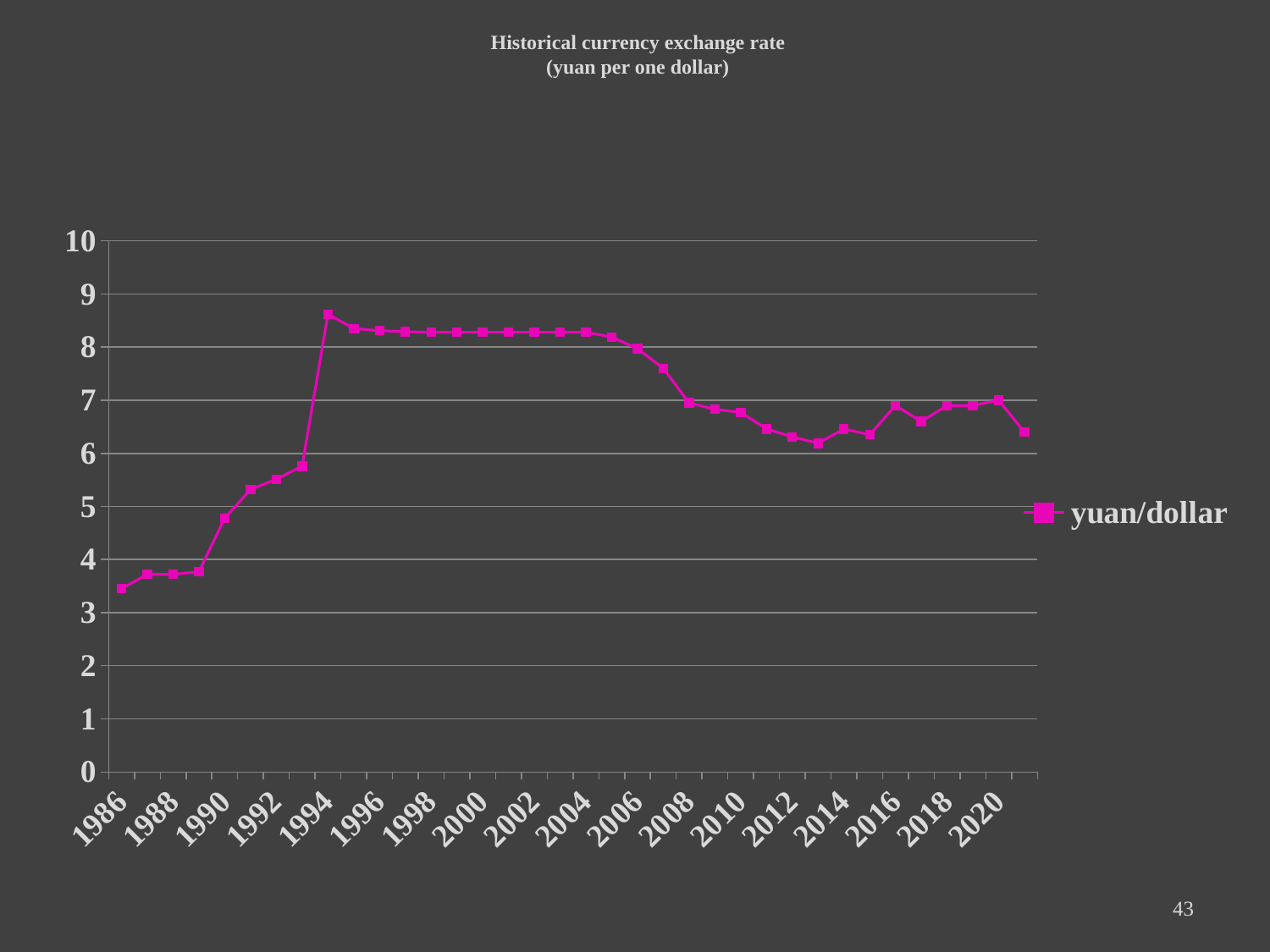
In which year is the yuan/dollar value highest? 1994 What is the title of the chart? Historical currency exchange rate (yuan per one dollar) What is the name of the series shown in the legend? yuan/dollar Is the value for 1994 greater or less than 8? greater Which year has the larger yuan/dollar value, 1994 or 2012? 1994 In which year is the yuan/dollar value lowest? 1986 What kind of chart is shown on the slide? line chart Is the value for 1990 greater or less than 5? less How many series does the legend list? 1 Is the value for 2012 greater or less than 7? less Does the yuan/dollar value rise or fall from 1986 to 1994? rise